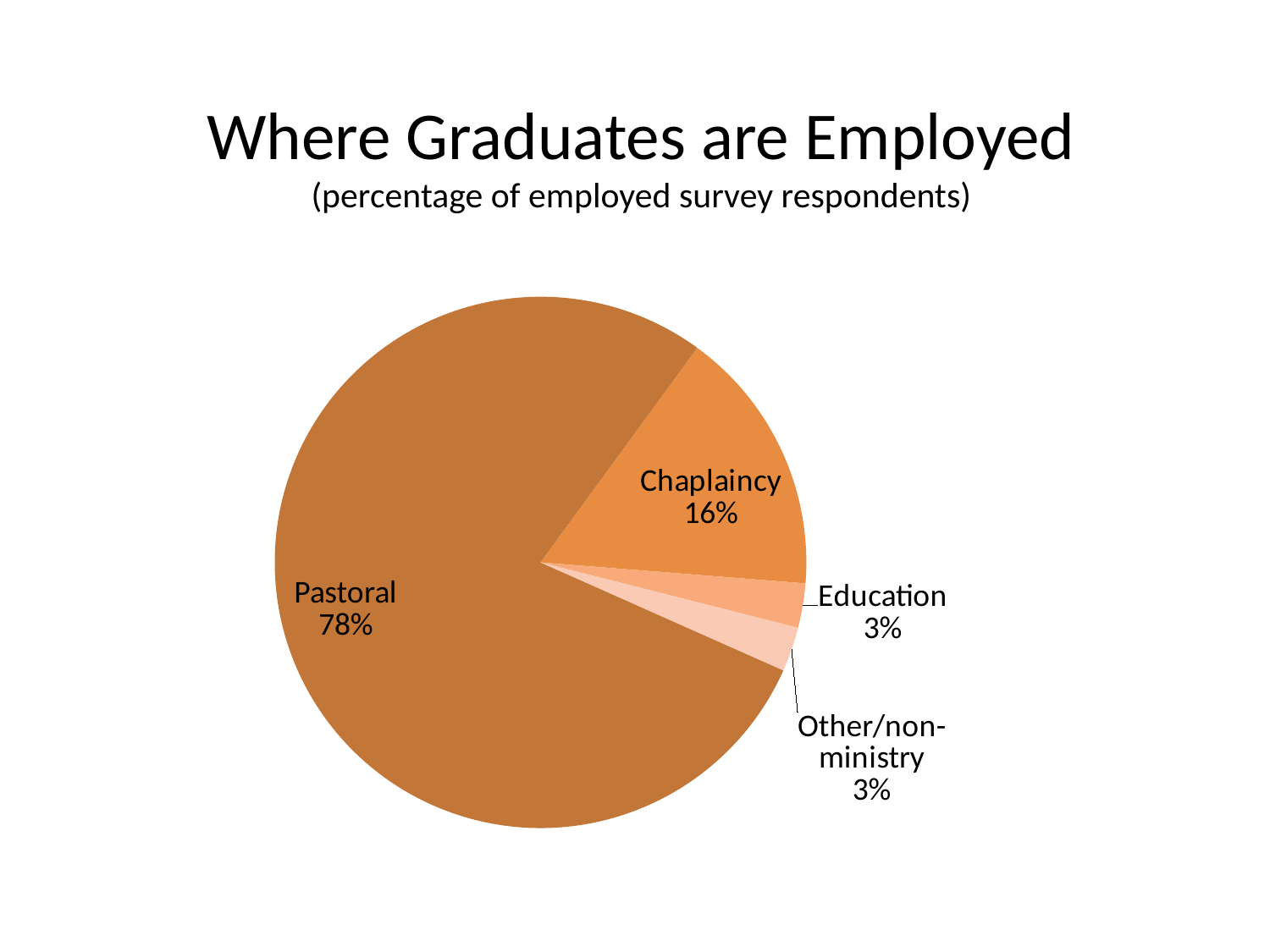
What is the difference in percentage points between Pastoral and Chaplaincy? 62 What is the combined share of Education and Other/non-ministry? 6% What percentage of employed graduates are in Chaplaincy? 16% What is the title of the chart? Where Graduates are Employed What percentage of employed graduates are in Other/non-ministry roles? 3% What kind of chart is shown on the slide? pie chart How many slices does the pie chart have? 4 What percentage of employed graduates are in Pastoral roles? 78% Which category has the largest share of the pie? Pastoral What does the subtitle say the percentages are based on? percentage of employed survey respondents What percentage of employed graduates are in Education? 3% Which is larger, the Chaplaincy share or the Education share? Chaplaincy